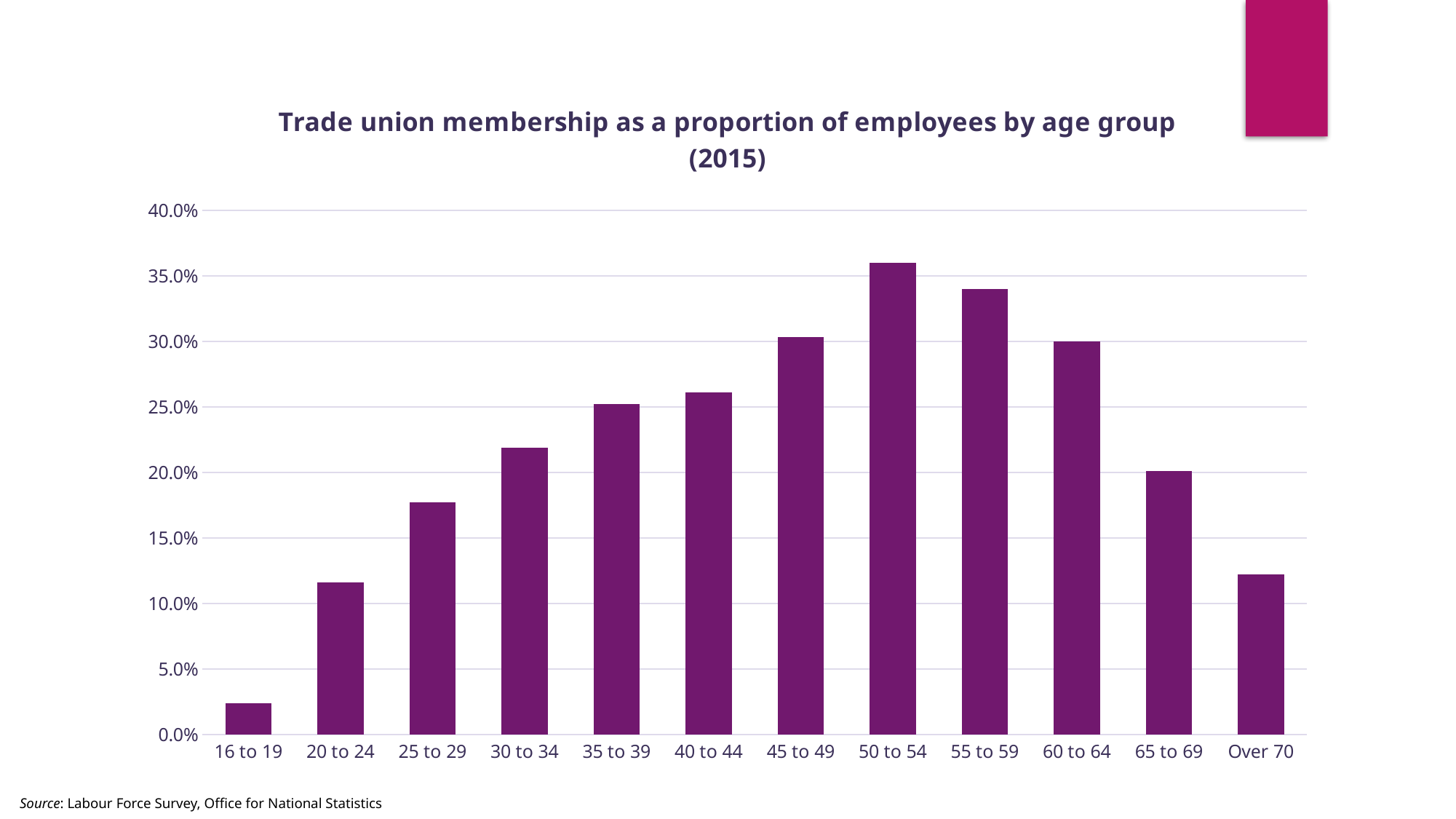
Is the value for 25 to 29 greater or less than 15.0%? greater Which is larger, the value for 30 to 34 or the value for 60 to 64? 60 to 64 What is the title of the chart? Trade union membership as a proportion of employees by age group (2015) Is the value for 16 to 19 greater or less than 5.0%? less Do the values rise or fall from the 16 to 19 group to the 50 to 54 group? rise Is the value for Over 70 greater or less than 10.0%? greater Which age group has the lowest trade union membership proportion? 16 to 19 What kind of chart is shown on the slide? bar chart Which is larger, the value for 50 to 54 or the value for 55 to 59? 50 to 54 Which age group has the highest trade union membership proportion? 50 to 54 How many age groups are shown on the x axis? 12